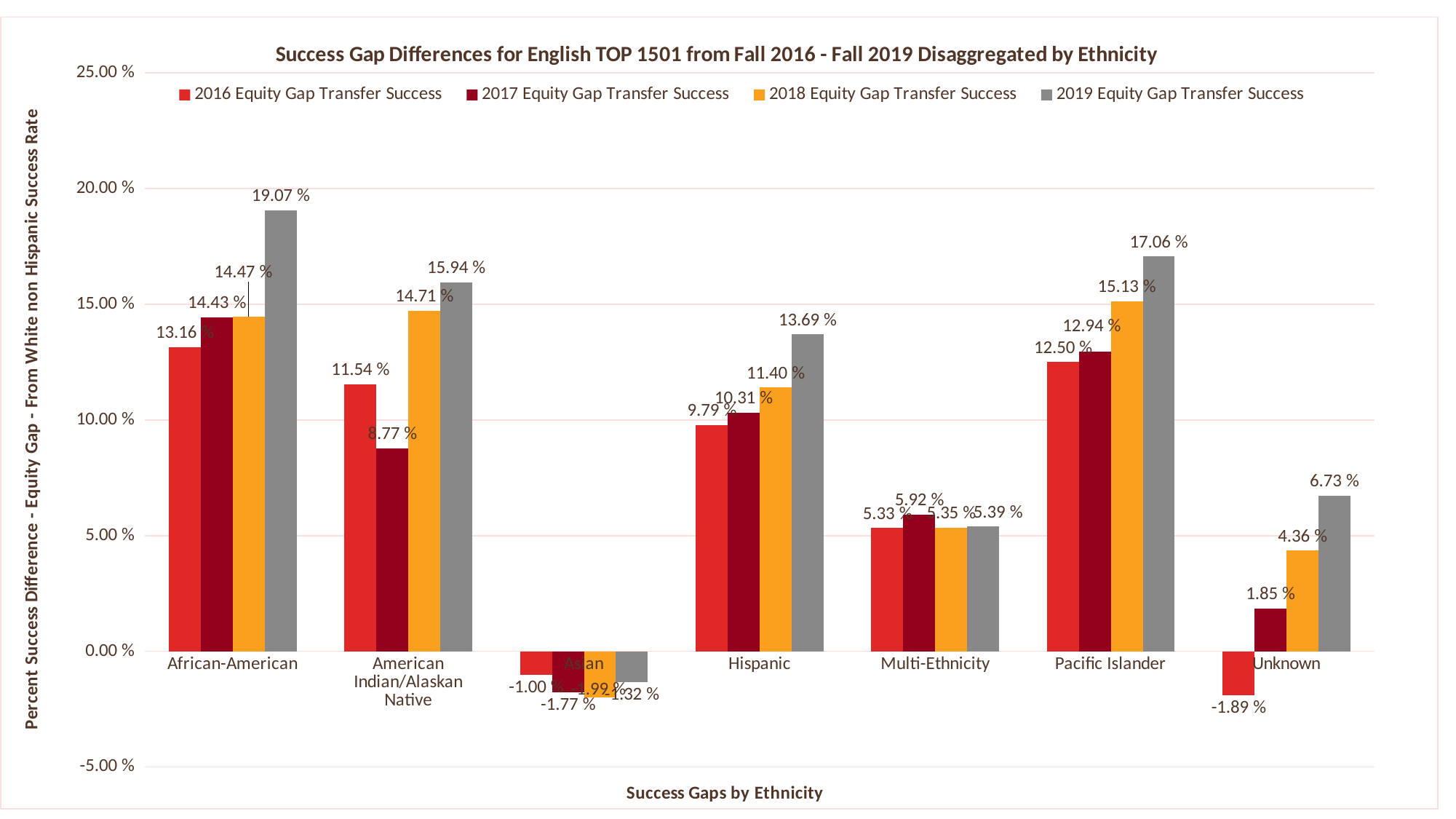
What is the difference between the 2019 and 2016 Equity Gap Transfer Success values for African-American? 5.91 % What kind of chart is shown on the slide? Bar chart Which ethnicity has the lowest 2016 Equity Gap Transfer Success value? Unknown How many ethnicity categories are shown on the x axis? 7 What is the difference between the 2019 and 2018 Equity Gap Transfer Success values for Pacific Islander? 1.93 % What is the 2017 Equity Gap Transfer Success value for Hispanic? 10.31 % Do the Equity Gap Transfer Success values for Unknown rise or fall from 2016 to 2019? Rise Which ethnicity has the highest 2019 Equity Gap Transfer Success value? African-American Which is larger, the 2018 Equity Gap Transfer Success value for Pacific Islander or for Hispanic? Pacific Islander What is the 2019 Equity Gap Transfer Success value for African-American? 19.07 % What is the 2017 Equity Gap Transfer Success value for American Indian/Alaskan Native? 8.77 % How many series does the legend list? 4